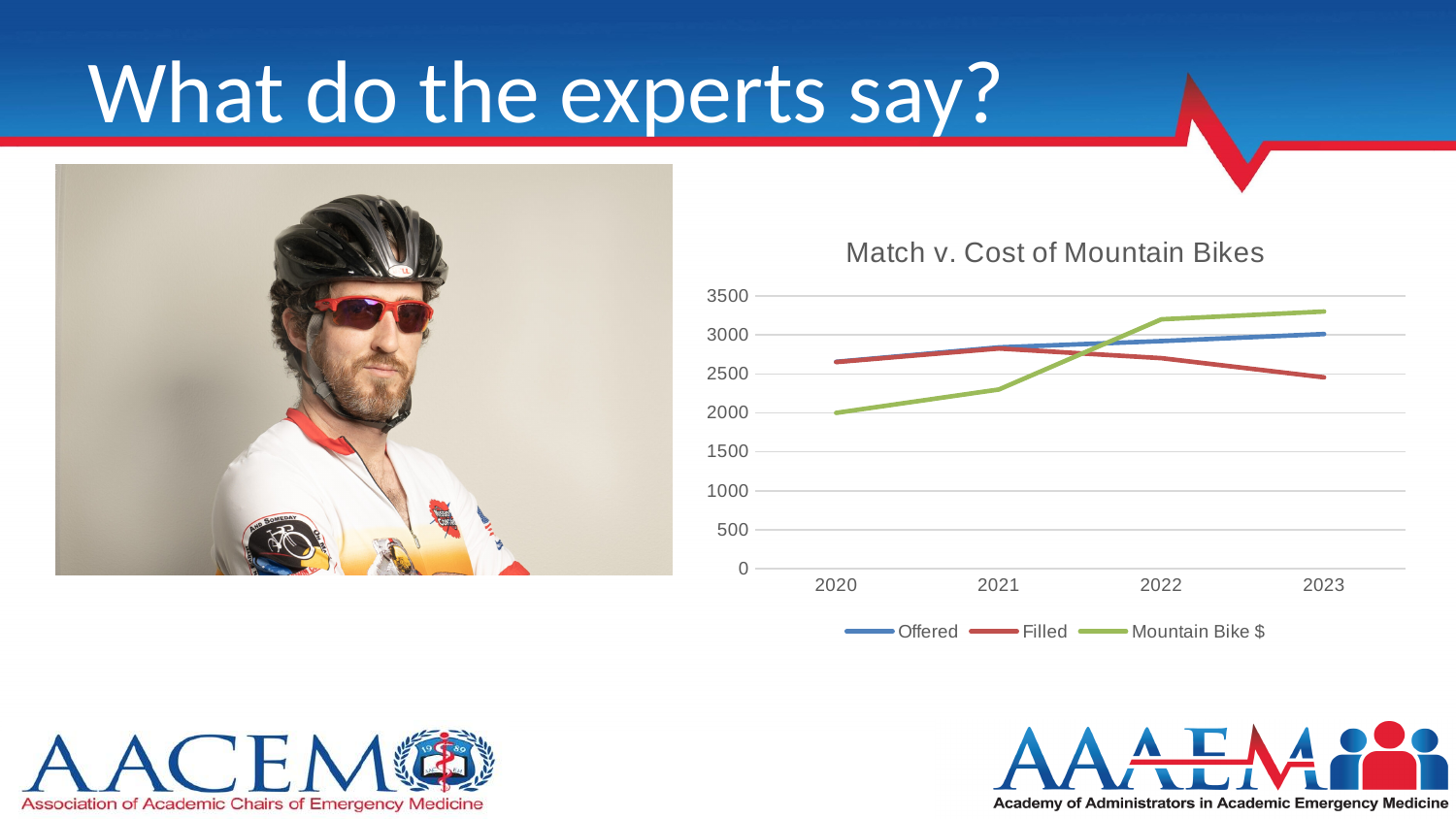
What is the title of the chart? Match v. Cost of Mountain Bikes How many series does the chart's legend list? 3 What type of chart is shown on the slide? line chart Is the value for Mountain Bike $ in 2020 greater or less than 2500? less Is the value for Filled in 2023 greater or less than 3000? less Is the value for Mountain Bike $ in 2023 greater or less than 3000? greater How many years are shown on the x axis of the chart? 4 Which series has the highest value in 2023? Mountain Bike $ Which series has the lowest value in 2020? Mountain Bike $ In 2023, which is larger: Offered or Filled? Offered Does the Mountain Bike $ line rise or fall from 2020 to 2023? rise